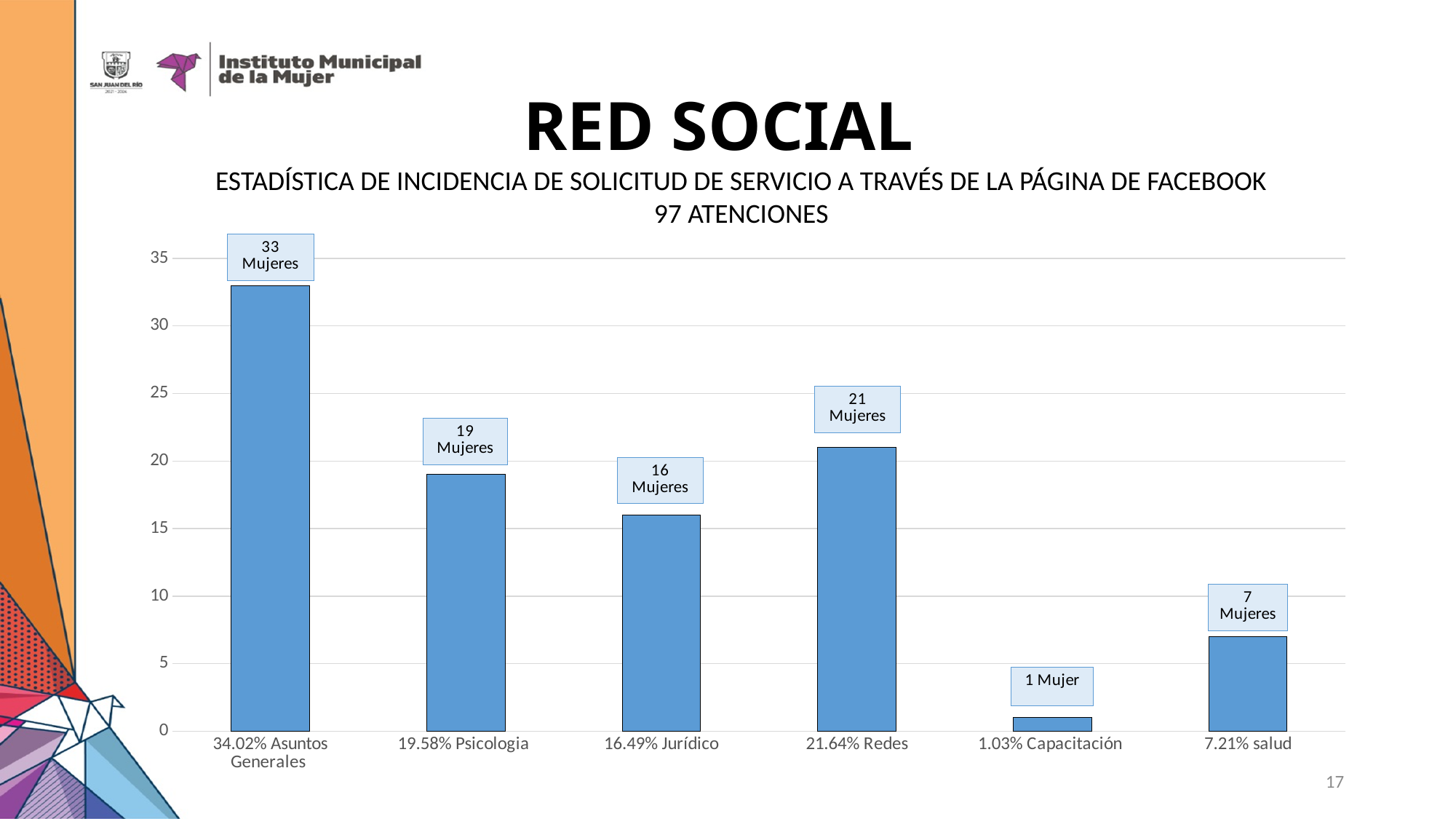
What is the value for 1.03% Capacitación? 1 Mujer Which category has the lowest value? 1.03% Capacitación Which is larger, the value for 19.58% Psicologia or the value for 21.64% Redes? 21.64% Redes What is the value for 19.58% Psicologia? 19 Mujeres Which category has the highest value? 34.02% Asuntos Generales What kind of chart is shown on the slide? bar chart Is the value for 7.21% salud greater or less than 10? less What is the value for 21.64% Redes? 21 Mujeres What is the difference between the values for 34.02% Asuntos Generales and 16.49% Jurídico? 17 How many categories are shown on the x axis? 6 What is the total number of atenciones stated in the chart subtitle? 97 What is the difference between the values for 21.64% Redes and 7.21% salud? 14